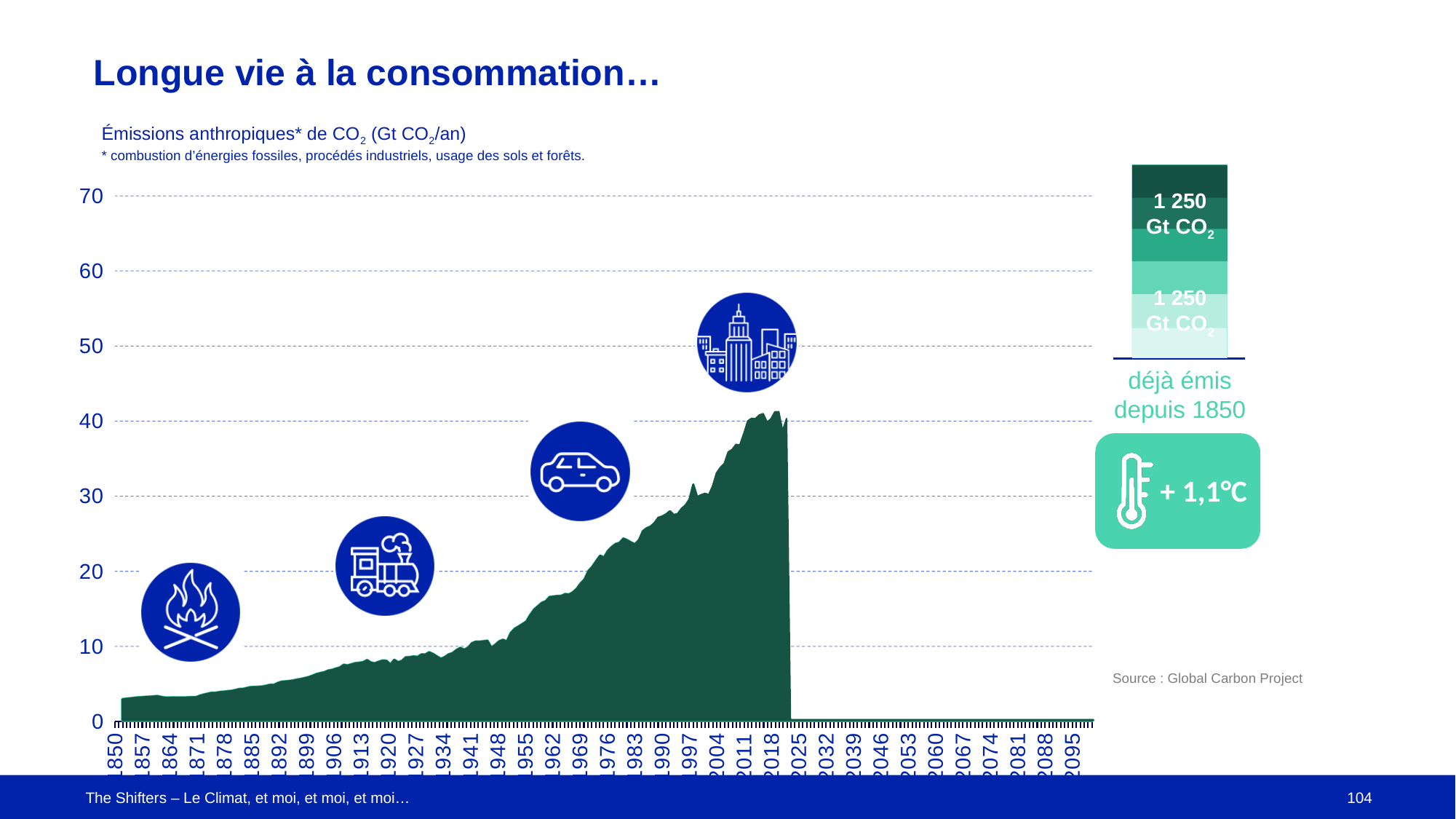
Is the value for 2011 greater or less than 30? greater What is the highest value shown on the y axis? 70 Is the value for 1990 greater or less than 20? greater What kind of chart is shown on the slide? area chart Do the CO2 emissions rise or fall from 1850 to around 2018? rise Is the value for 1920 greater or less than 10? less What is the first year shown on the x axis? 1850 What temperature increase is shown in the box on the right of the slide? + 1,1°C